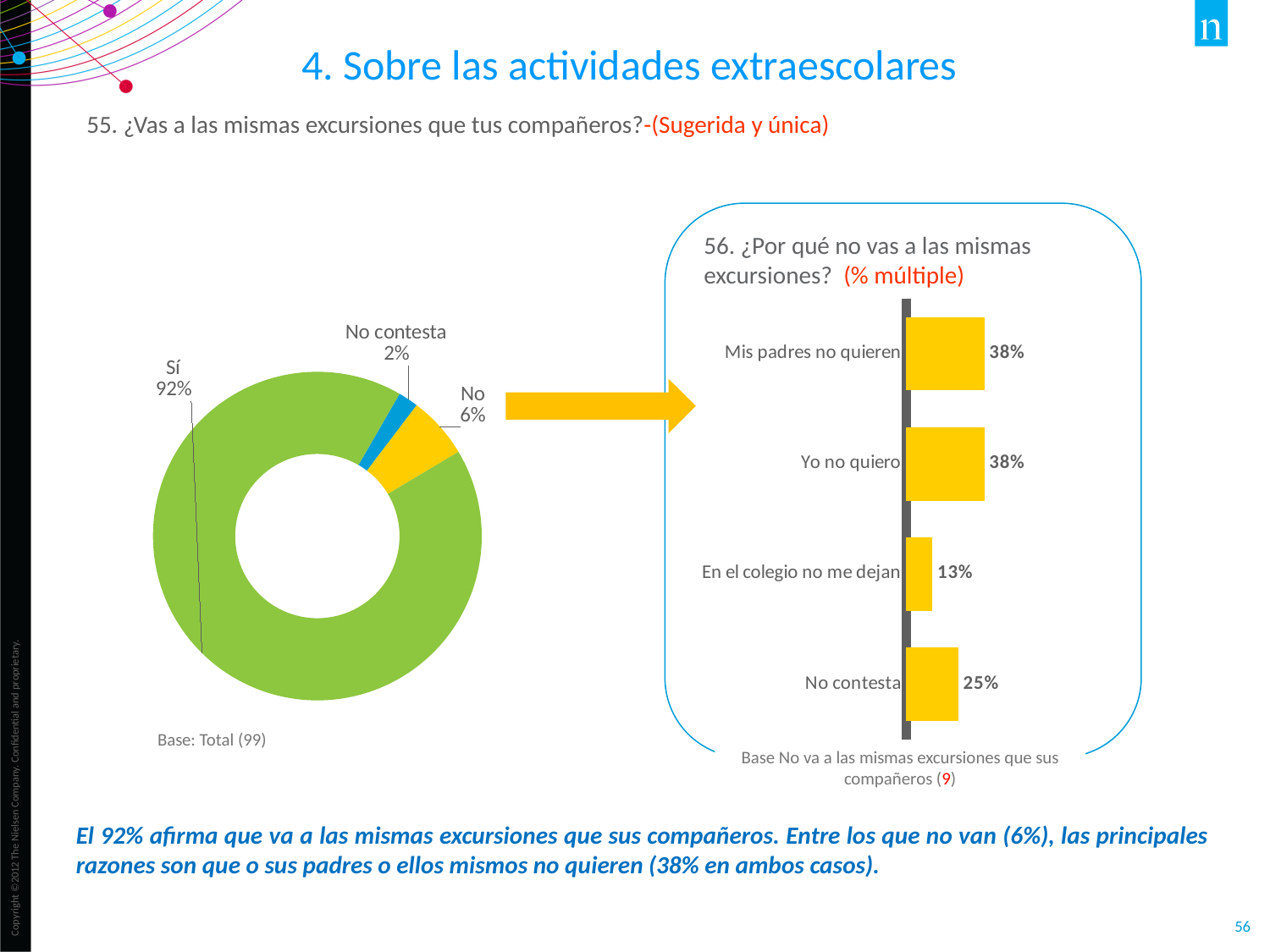
In the donut chart on the left, what percentage is "No contesta"? 2% In the donut chart on the left, which category has the largest share? Sí In the donut chart on the left, what percentage answered "Sí"? 92% In the donut chart on the left, how many categories are shown? 3 In the bar chart on the right (question 56), what is the value for "Mis padres no quieren"? 38% What kind of chart is the chart on the left of the slide? Donut (pie) chart In the donut chart on the left, what percentage answered "No"? 6% In the bar chart on the right (question 56), which category has the lowest value? En el colegio no me dejan In the bar chart on the right (question 56), how many categories are shown? 4 In the bar chart on the right (question 56), what is the value for "En el colegio no me dejan"? 13% In the bar chart on the right (question 56), what is the difference between "Yo no quiero" and "No contesta"? 13% In the donut chart on the left, which category has the smallest share? No contesta